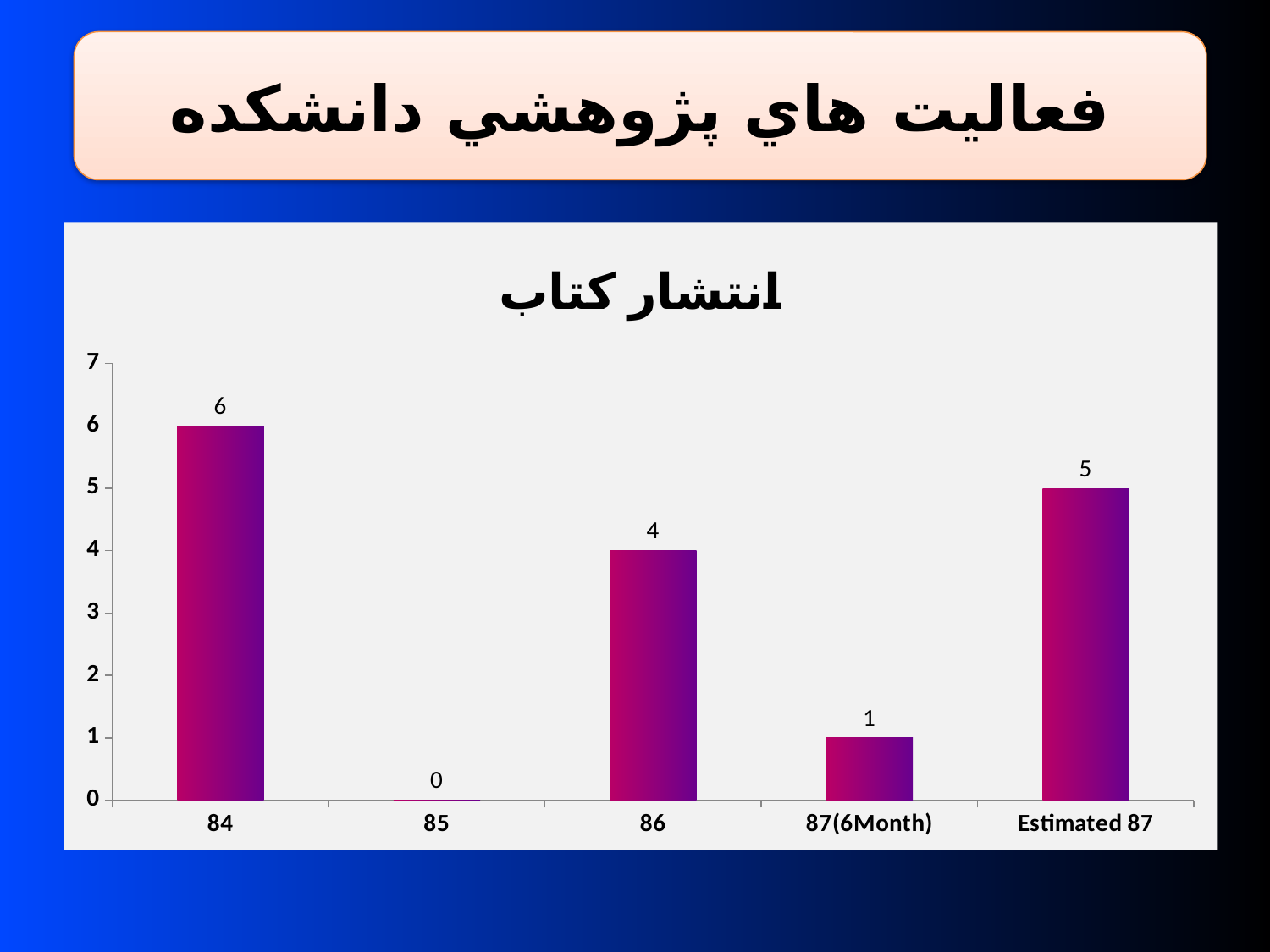
Which category has the lowest value? 85 What kind of chart is this? bar chart What is the difference between the values for 84 and Estimated 87? 1 How many categories are shown on the x axis? 5 What is the value for Estimated 87? 5 What is the title of the chart? انتشار کتاب What is the value for 87(6Month)? 1 Which is larger, the value for 86 or the value for Estimated 87? Estimated 87 Which category has the highest value? 84 What is the value for 84? 6 What is the value for 85? 0 What is the value for 86? 4